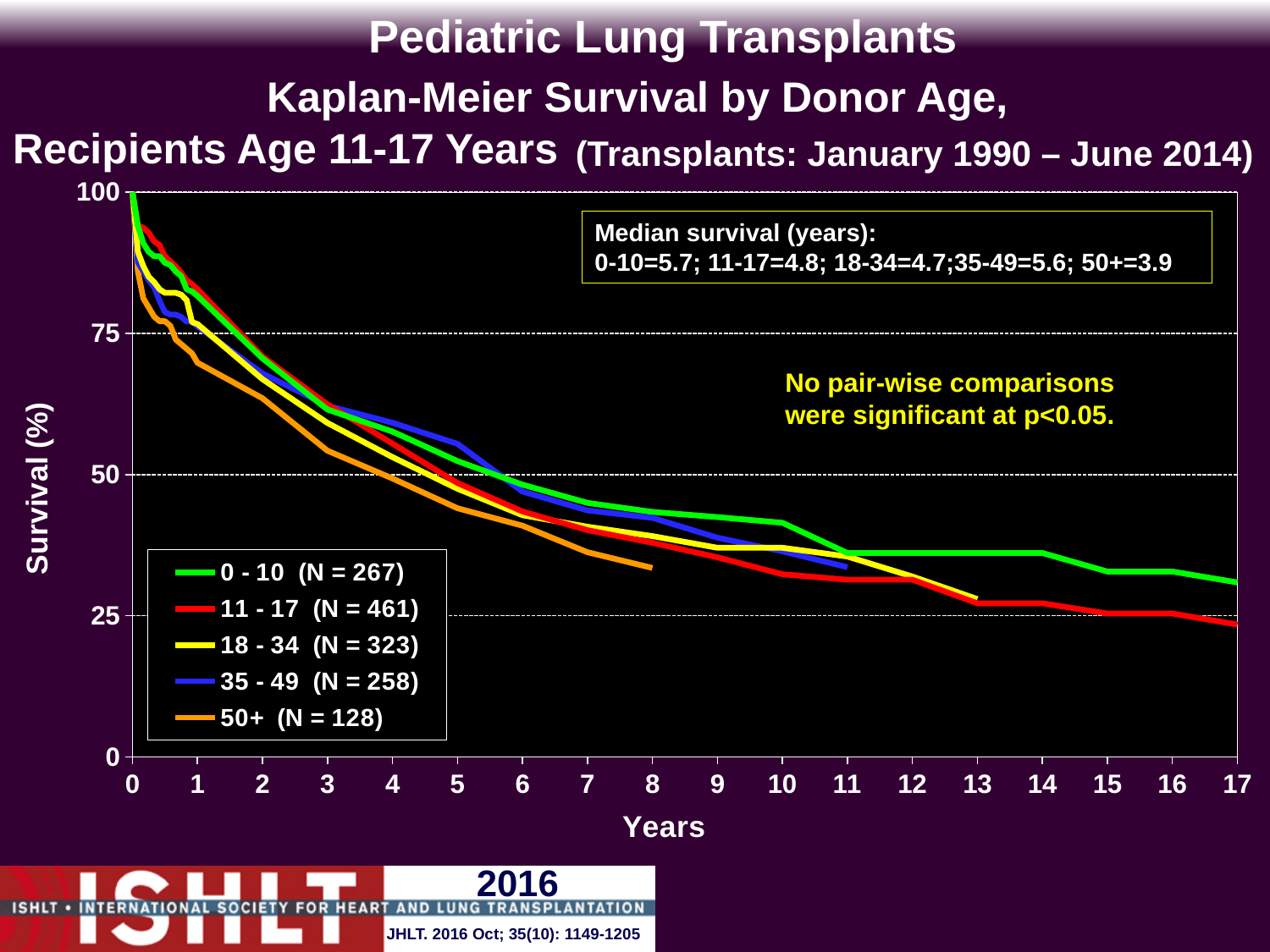
What is the N for the 11 - 17 donor age group in the legend? 461 Do the survival curves rise or fall as years increase? fall What kind of chart is shown on the slide? line chart What is the difference in median survival (years) between the 0-10 and 50+ donor age groups? 1.8 Is the survival value for the 0 - 10 donor age group at 17 years greater or less than 25? greater Which donor age group has the longest median survival? 0-10 What is the median survival in years for the 0-10 donor age group? 5.7 Which donor age group has the shortest median survival? 50+ Is the survival value for the 50+ donor age group at 5 years greater or less than 50? less How many donor age groups (series) does the legend list? 5 Which donor age group has a larger N, 18 - 34 or 35 - 49? 18 - 34 What colour is the line for the 50+ donor age group? orange